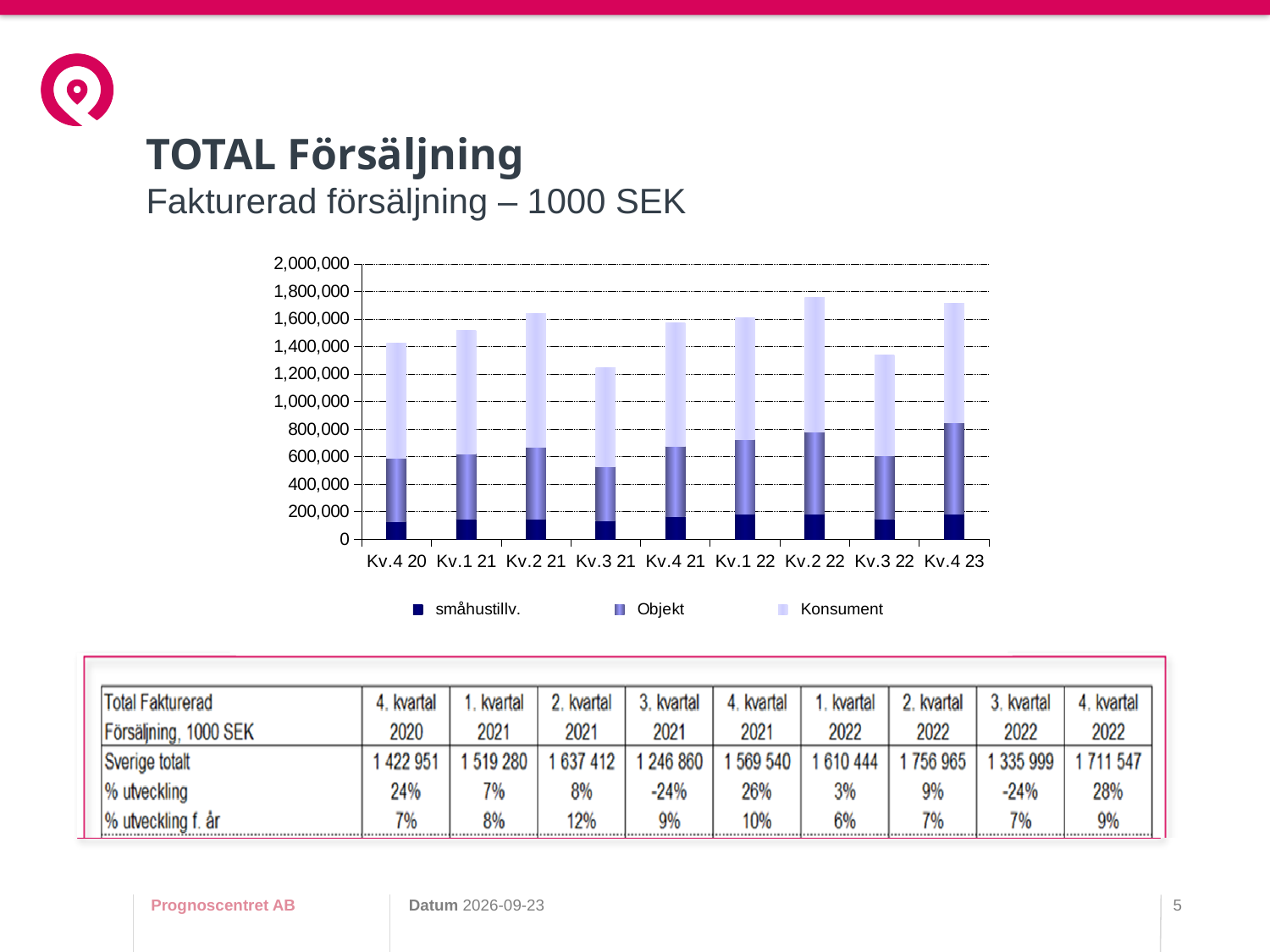
How many quarters (bars) are plotted on the x axis of the chart? 9 How many series does the chart legend list? 3 Which total bar is larger, Kv.4 21 or Kv.3 21? Kv.4 21 Do the total bars rise or fall from Kv.4 20 to Kv.2 21? rise Using the table values, what is the difference between Sverige totalt for 2. kvartal 2022 and 3. kvartal 2022? 420 966 According to the table below the chart, what is the total invoiced sales (Sverige totalt) for 3. kvartal 2021? 1 246 860 Is the total bar for Kv.3 21 greater or less than 1,400,000? less What kind of chart is shown on the slide? bar chart Which quarter has the lowest total bar in the chart? Kv.3 21 Is the total bar for Kv.2 22 greater or less than 1,600,000? greater Which series is shown at the top of each stacked bar, according to the legend? Konsument Which quarter has the highest total bar in the chart? Kv.2 22